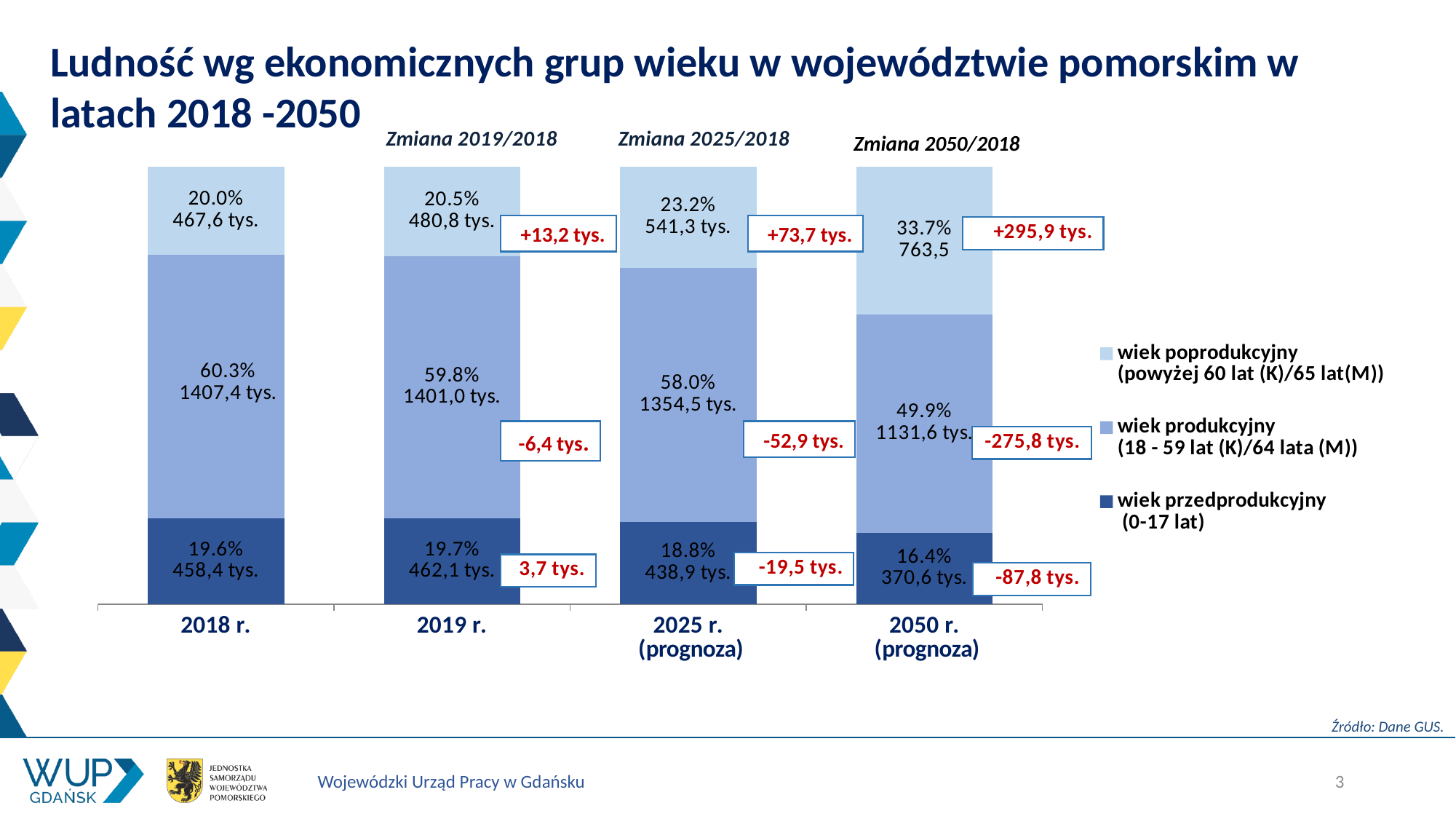
How many years (categories) are shown on the x axis? 4 In 2019 r., which group has the larger share: wiek poprodukcyjny or wiek przedprodukcyjny? wiek poprodukcyjny In which year does the wiek poprodukcyjny group have the highest percentage share? 2050 r. (prognoza) Does the share of the wiek poprodukcyjny group rise or fall from 2018 r. to 2050 r. (prognoza)? rise How many series does the legend list? 3 What change (Zmiana 2050/2018) is annotated for the wiek poprodukcyjny group? +295,9 tys. What percentage share does the wiek produkcyjny group have in 2018 r.? 60.3% How many people (in tys.) are in the wiek poprodukcyjny group in 2050 r. (prognoza)? 763,5 What is the value in tys. for the wiek przedprodukcyjny group in 2025 r. (prognoza)? 438,9 tys. What kind of chart is shown on the slide? stacked bar chart In which year does the wiek przedprodukcyjny group have the lowest percentage share? 2050 r. (prognoza) By how many tys. does the wiek produkcyjny group in 2050 r. (prognoza) differ from 2018 r.? 275,8 tys.